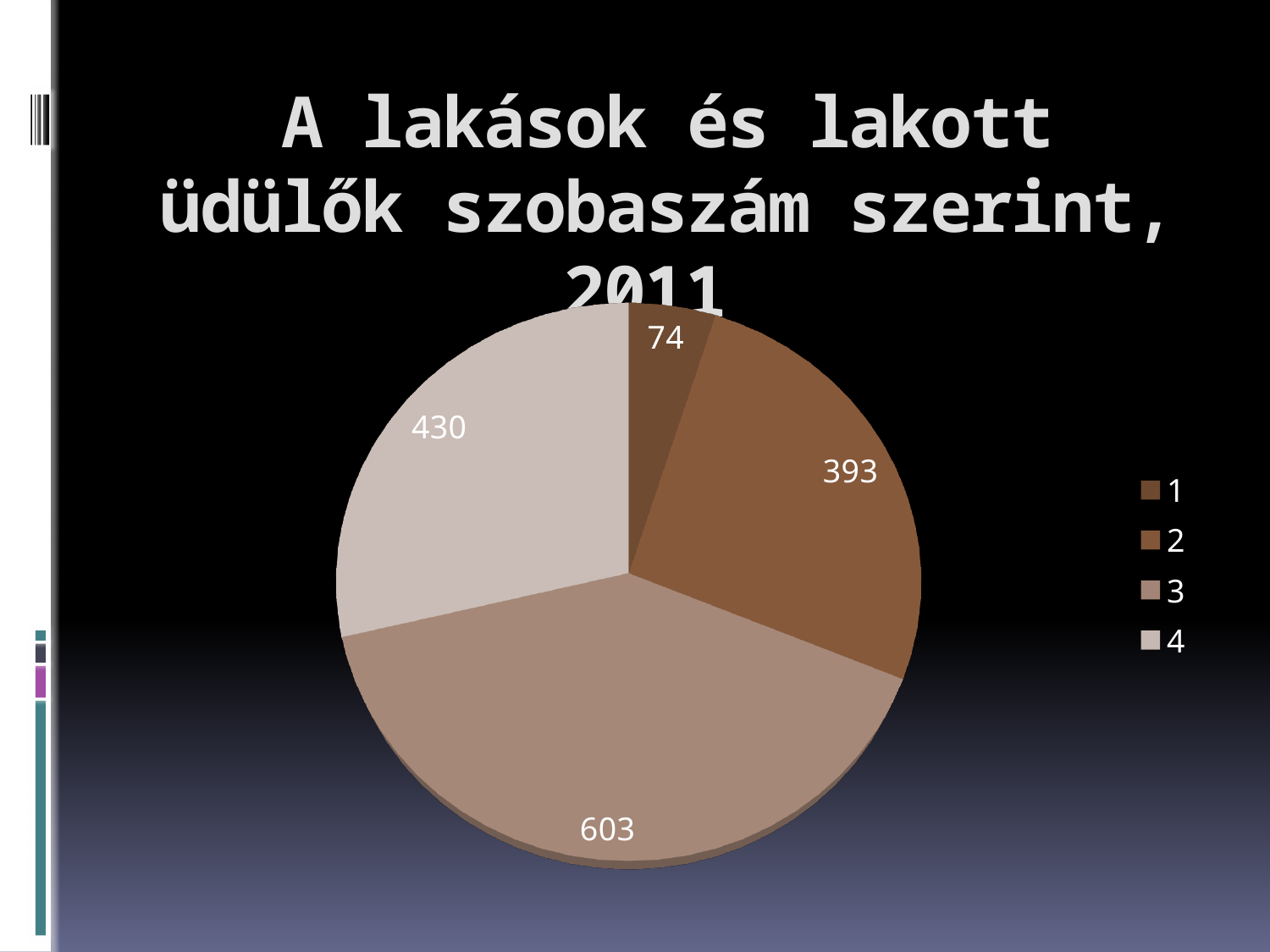
Which category has the smallest slice in the pie chart? 1 What is the value for category 4 in the pie chart? 430 What is the difference between the values for category 3 and category 4? 173 Which category has the largest slice in the pie chart? 3 What is the value for category 3 in the pie chart? 603 Which is larger, the value for category 2 or the value for category 4? 4 What kind of chart is shown on the slide? pie chart How many slices does the pie chart have? 4 What is the total of all slices in the pie chart? 1500 What is the difference between the values for category 2 and category 1? 319 What is the value for category 1 in the pie chart? 74 What is the title of the chart? A lakások és lakott üdülők szobaszám szerint, 2011